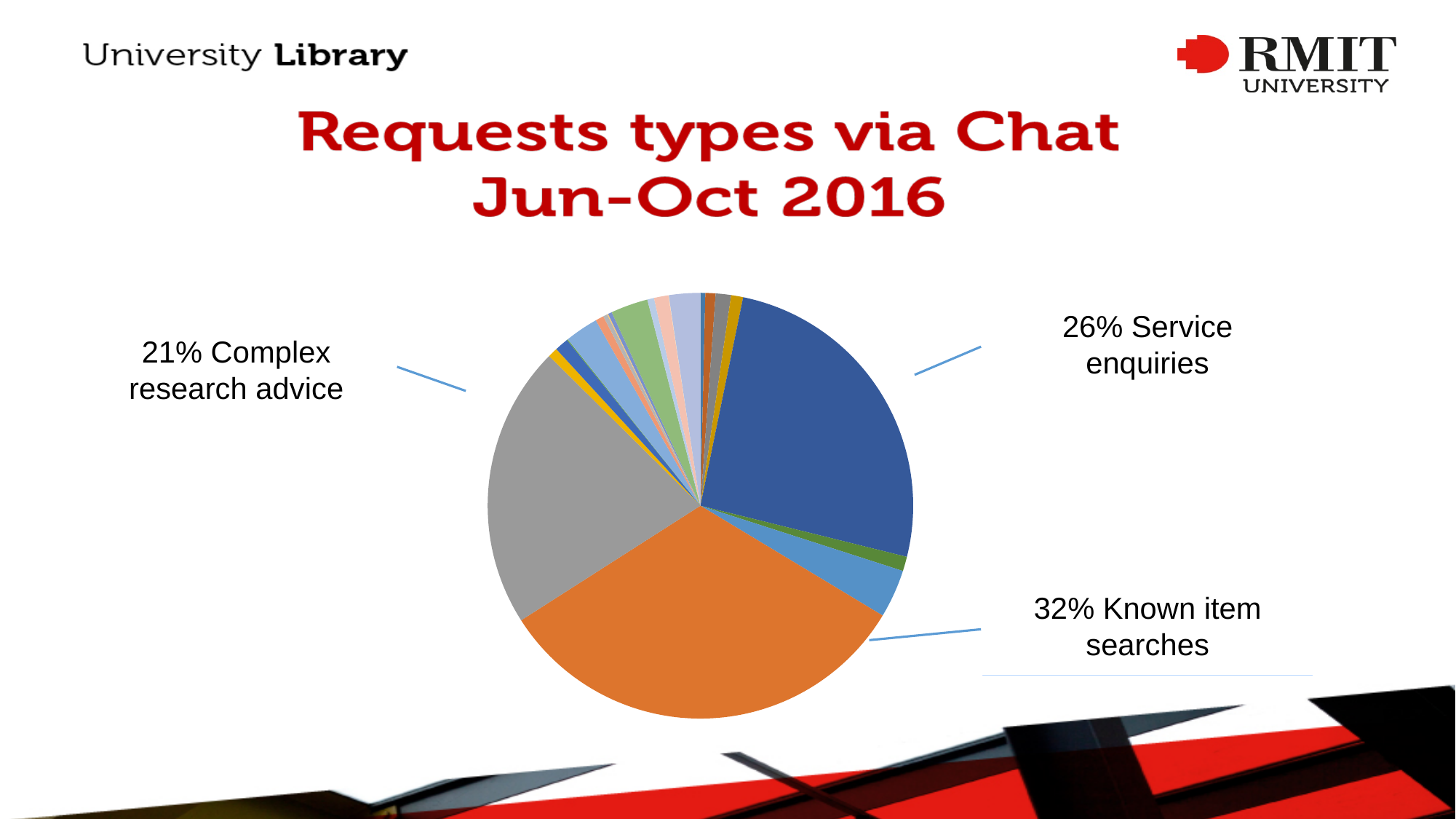
Which labelled request type has the largest slice of the pie? Known item searches How many slices of the pie have a percentage label on the slide? 3 What is the difference in percentage points between Known item searches and Service enquiries? 6 What kind of chart is shown on the slide? Pie chart Which is larger: the share for Service enquiries or the share for Complex research advice? Service enquiries What share of requests via chat were Known item searches? 32% What share of requests via chat were Service enquiries? 26% Which labelled request type has the smallest slice of the pie? Complex research advice What is the difference in percentage points between Service enquiries and Complex research advice? 5 What share of requests via chat were Complex research advice? 21% What is the title of the chart on the slide? Requests types via Chat Jun-Oct 2016 What is the combined share of the three labelled request types? 79%